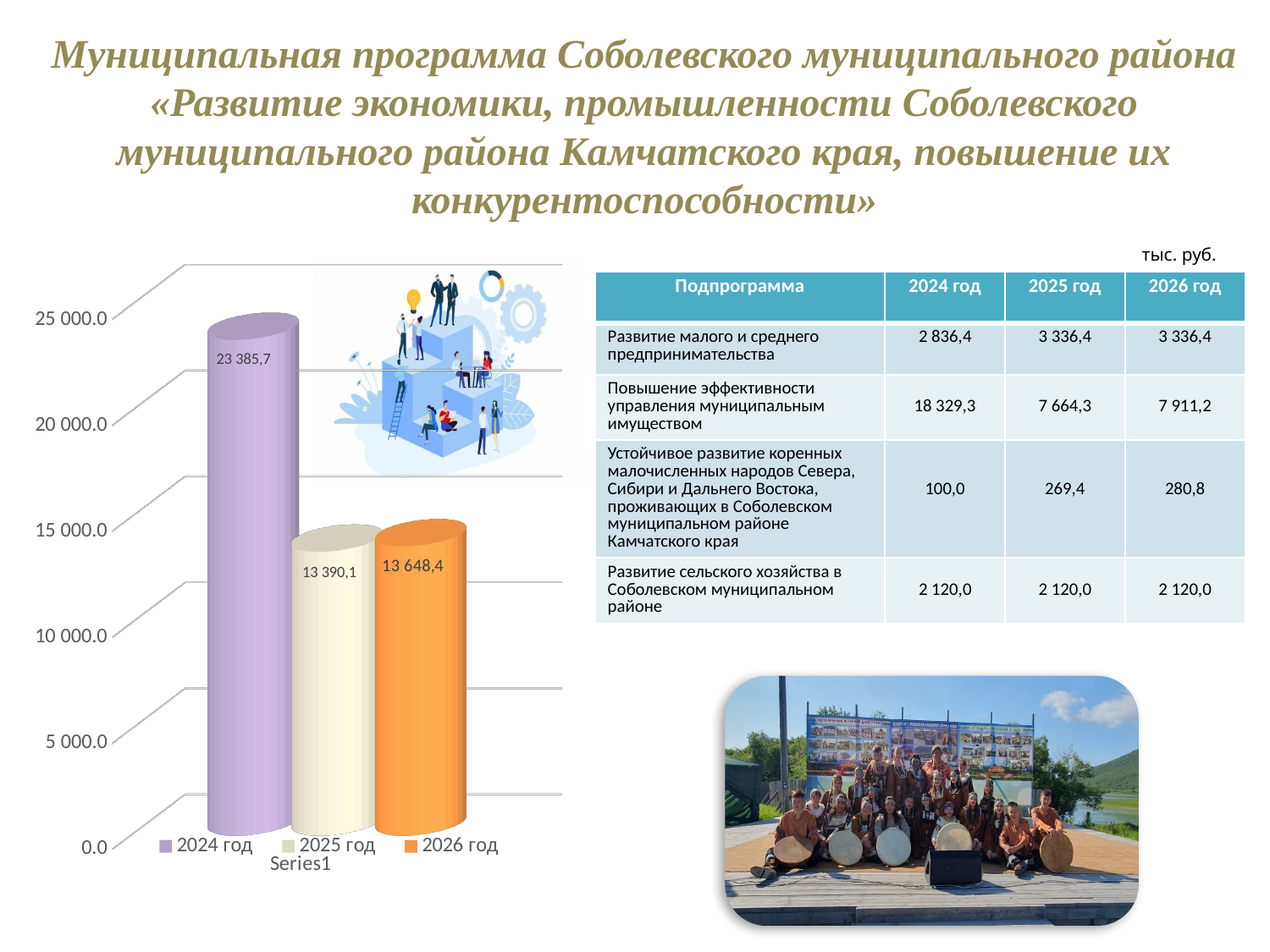
Is the value for 2025 год on the chart greater or less than 15 000.0? less What is the value shown for 2026 год on the chart? 13 648,4 What kind of chart is shown on the slide? bar chart Which year has the lowest value on the chart? 2025 год What colour is the bar for 2026 год on the chart? orange What is the value shown for 2025 год on the chart? 13 390,1 What is the value shown for 2024 год on the chart? 23 385,7 How many series does the chart legend list? 3 What is the difference between the values for 2026 год and 2025 год on the chart? 258,3 What is the difference between the values for 2024 год and 2025 год on the chart? 9 995,6 Which year has the highest value on the chart? 2024 год Which is larger on the chart: the value for 2024 год or the value for 2026 год? 2024 год